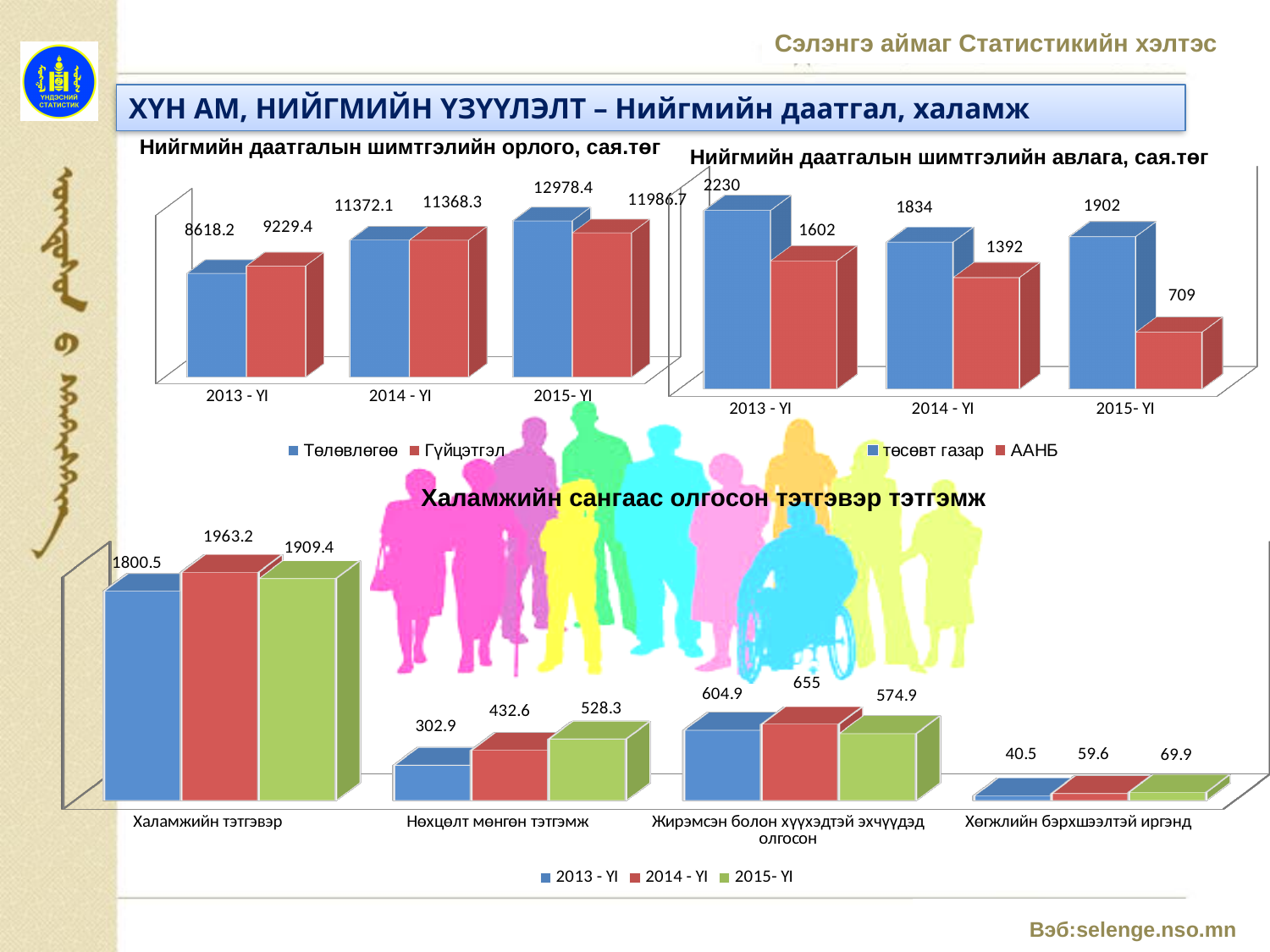
How many series does the legend of the chart 'Нийгмийн даатгалын шимтгэлийн авлага, сая.төг' list? 2 In the chart 'Нийгмийн даатгалын шимтгэлийн орлого, сая.төг', what is the difference between the Төлөвлөгөө and Гүйцэтгэл values for 2015- YI? 991.7 In the chart 'Нийгмийн даатгалын шимтгэлийн орлого, сая.төг', what is the Төлөвлөгөө value for 2013 - YI? 8618.2 In the chart 'Халамжийн сангаас олгосон тэтгэвэр тэтгэмж', what is the 2014 - YI value for Нөхцөлт мөнгөн тэтгэмж? 432.6 In the chart 'Халамжийн сангаас олгосон тэтгэвэр тэтгэмж', which is larger for Жирэмсэн болон хүүхэдтэй эхчүүдэд олгосон: the 2014 - YI value or the 2015- YI value? 2014 - YI In the chart 'Нийгмийн даатгалын шимтгэлийн авлага, сая.төг', what is the ААНБ value for 2015- YI? 709 In the chart 'Нийгмийн даатгалын шимтгэлийн авлага, сая.төг', what is the difference between төсөвт газар and ААНБ for 2014 - YI? 442 In the chart 'Халамжийн сангаас олгосон тэтгэвэр тэтгэмж', which category has the lowest values? Хөгжлийн бэрхшээлтэй иргэнд In the chart 'Нийгмийн даатгалын шимтгэлийн авлага, сая.төг', which year has the highest төсөвт газар value? 2013 - YI In the chart 'Нийгмийн даатгалын шимтгэлийн орлого, сая.төг', does the Төлөвлөгөө series rise or fall from 2013 - YI to 2015- YI? rise In the chart 'Нийгмийн даатгалын шимтгэлийн орлого, сая.төг', what is the Гүйцэтгэл value for 2015- YI? 11986.7 How many categories are shown on the x axis of the chart 'Халамжийн сангаас олгосон тэтгэвэр тэтгэмж'? 4